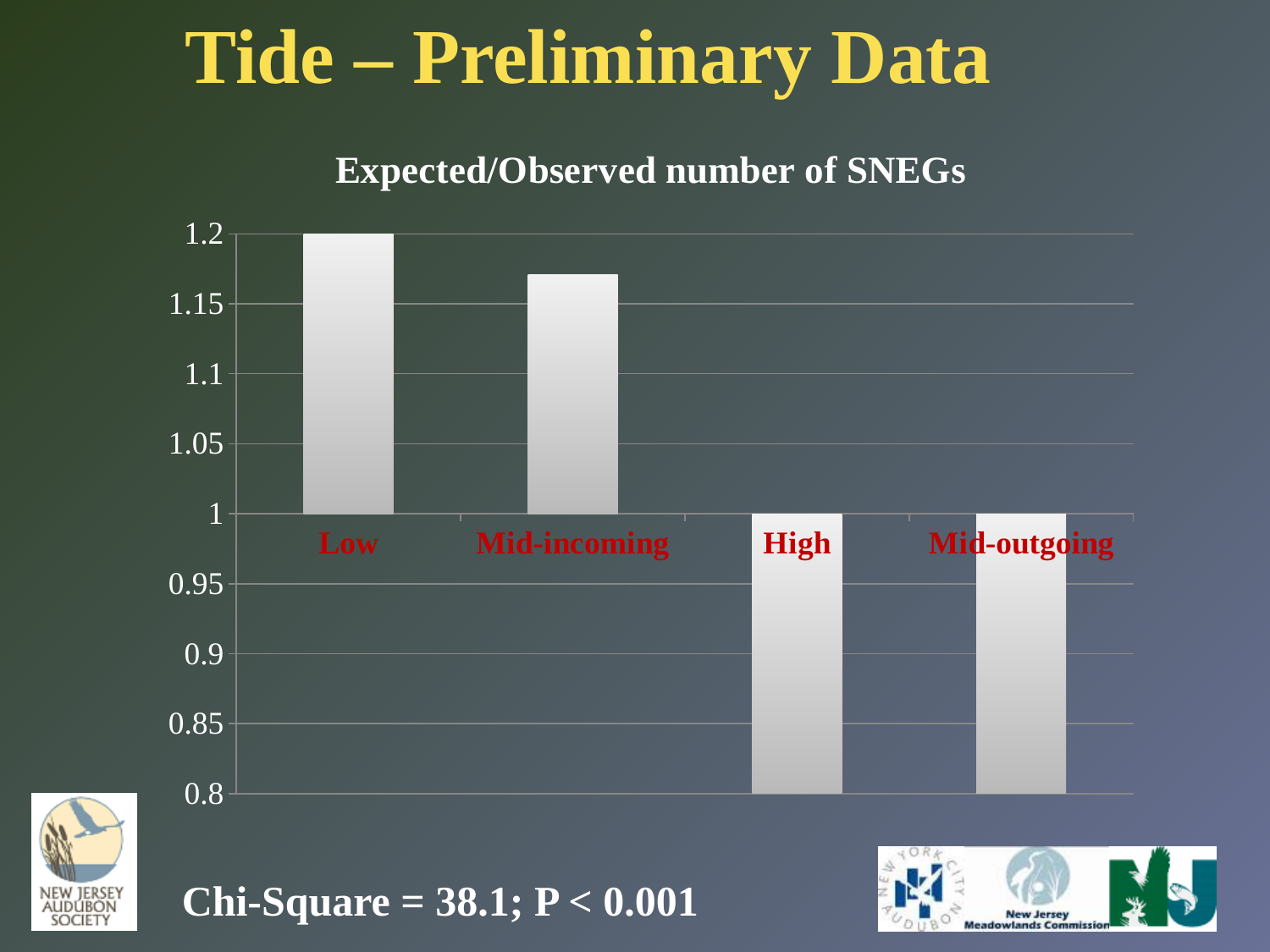
How many tide categories are plotted on the chart? 4 Which tide category has the highest value? Low What Chi-Square value is reported below the chart? 38.1 Is the value for Mid-outgoing greater or less than 0.9? less What is the title of the chart? Expected/Observed number of SNEGs Is the value for High greater or less than 1? less Is the value for Mid-incoming greater or less than 1.2? less Which is larger, the value for Low or the value for Mid-incoming? Low Do the values generally rise or fall moving from Low to Mid-outgoing along the x axis? fall What kind of chart is shown on the slide? bar chart